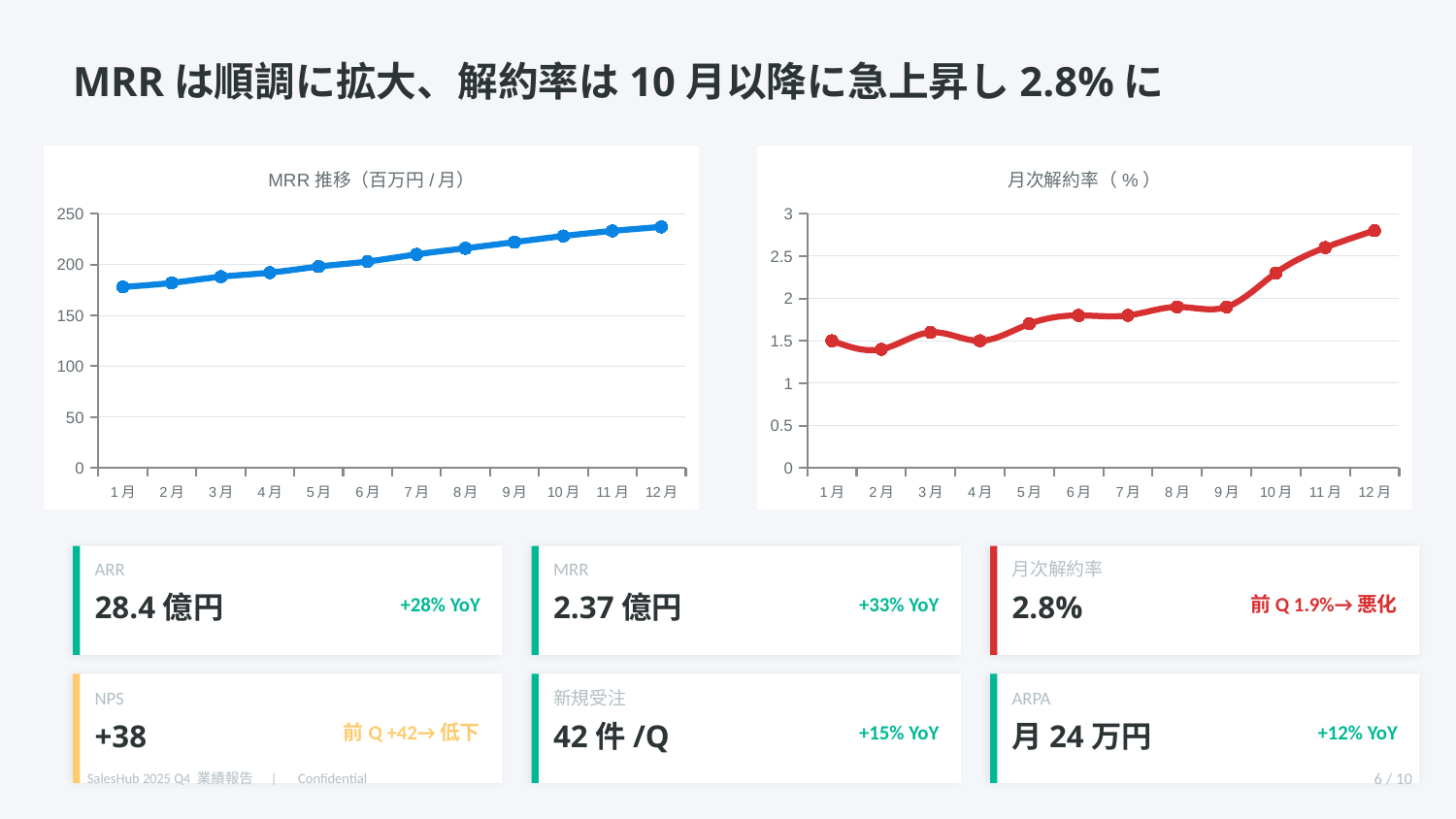
In the MRR 推移 chart on the left, which month has the highest value? 12月 In the MRR 推移 chart on the left, do the values rise or fall from 1月 to 12月? rise In the 月次解約率 chart on the right, which month has the highest value? 12月 In the MRR 推移 chart on the left, which is larger, the value for 3月 or the value for 6月? 6月 What kind of chart is the MRR 推移（百万円/月） chart on the left? line chart In the MRR 推移 chart on the left, is the value for 1月 greater or less than 200? less In the MRR 推移 chart on the left, is the value for 12月 greater or less than 200? greater In the 月次解約率 chart on the right, is the value for 10月 greater or less than 2? greater In the MRR 推移 chart on the left, how many months are plotted along the x axis? 12 What kind of chart is the 月次解約率（%） chart on the right? line chart In the MRR 推移 chart on the left, which month has the lowest value? 1月